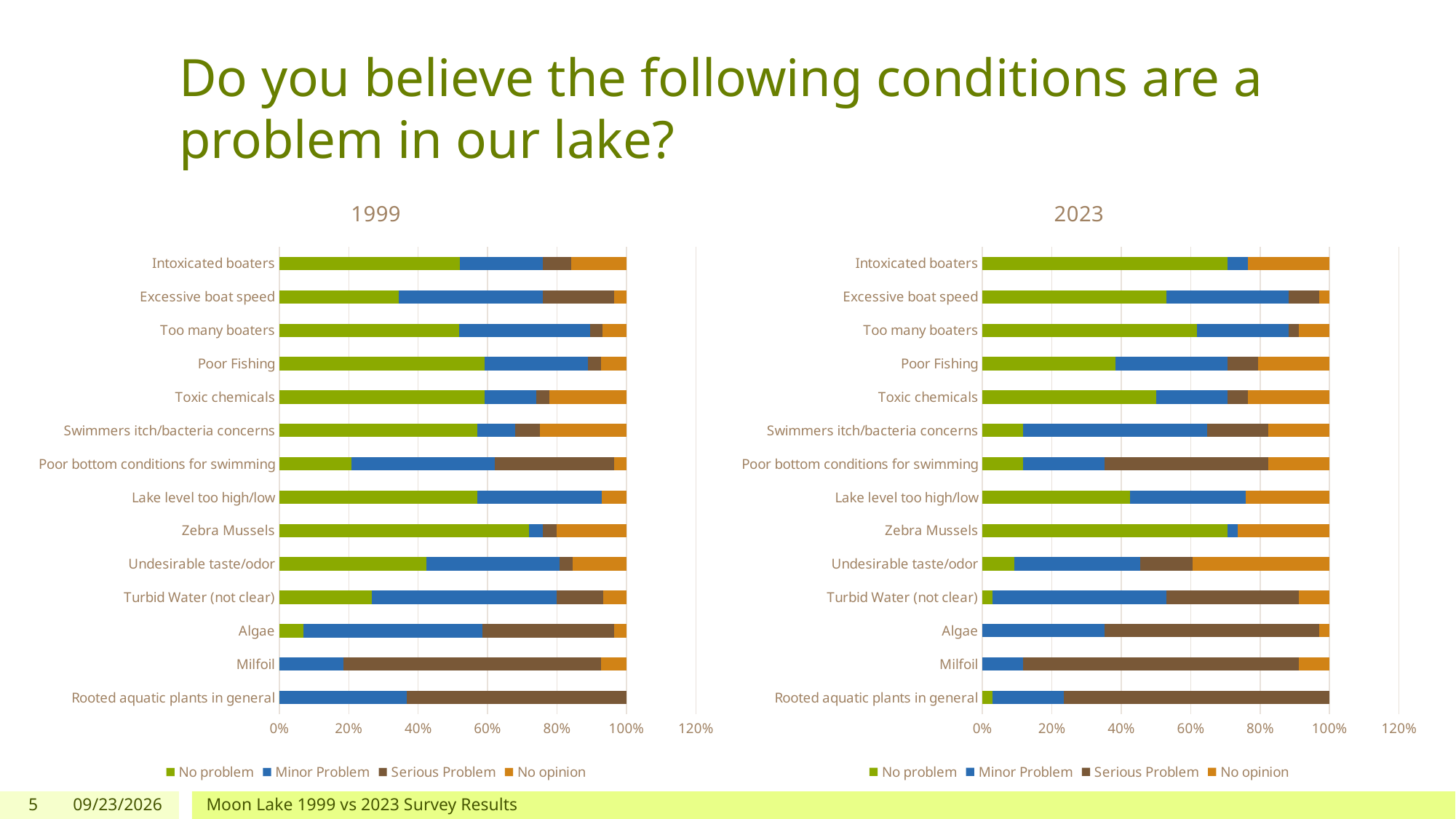
What kind of chart is the 1999 chart? Stacked bar chart How many categories are listed on the 2023 chart? 14 In the 2023 chart, is the Serious Problem value for Rooted aquatic plants in general greater or less than 60%? greater In the 2023 chart, is the No problem value for Turbid Water (not clear) greater or less than 20%? less In the 1999 chart, which category has the largest No problem segment? Zebra Mussels In the 2023 chart, is the No problem value for Intoxicated boaters greater or less than 60%? greater What are the titles of the two charts on the slide? 1999 and 2023 For Swimmers itch/bacteria concerns, is the No problem share larger in the 1999 chart or the 2023 chart? 1999 How many series does the legend of the 1999 chart list? 4 In the 2023 chart, which series is shown in green? No problem